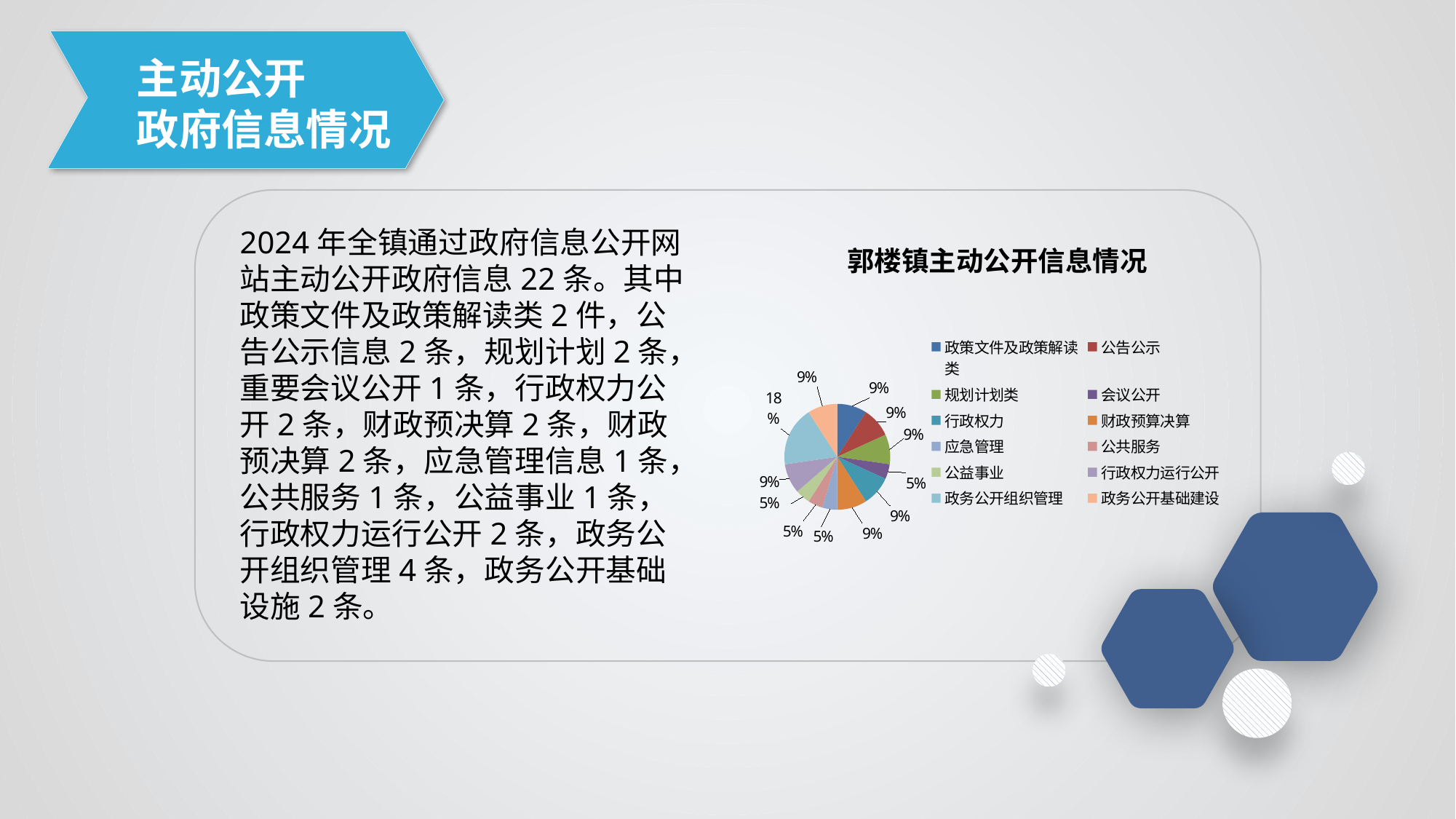
What share of the pie does 政务公开组织管理 have? 18% What share of the pie does 公告公示 have? 9% What is the difference between the share for 政务公开组织管理 and the share for 政务公开基础建设? 9% Which is larger, the share for 政务公开组织管理 or the share for 公告公示? 政务公开组织管理 What share of the pie does 会议公开 have? 5% What is the difference between the share for 行政权力 and the share for 应急管理? 4% What is the title of the chart? 郭楼镇主动公开信息情况 Which category has the largest share of the pie? 政务公开组织管理 How many entries does the chart legend list? 12 How many slices does the pie chart have? 12 What kind of chart is shown on the slide? pie chart